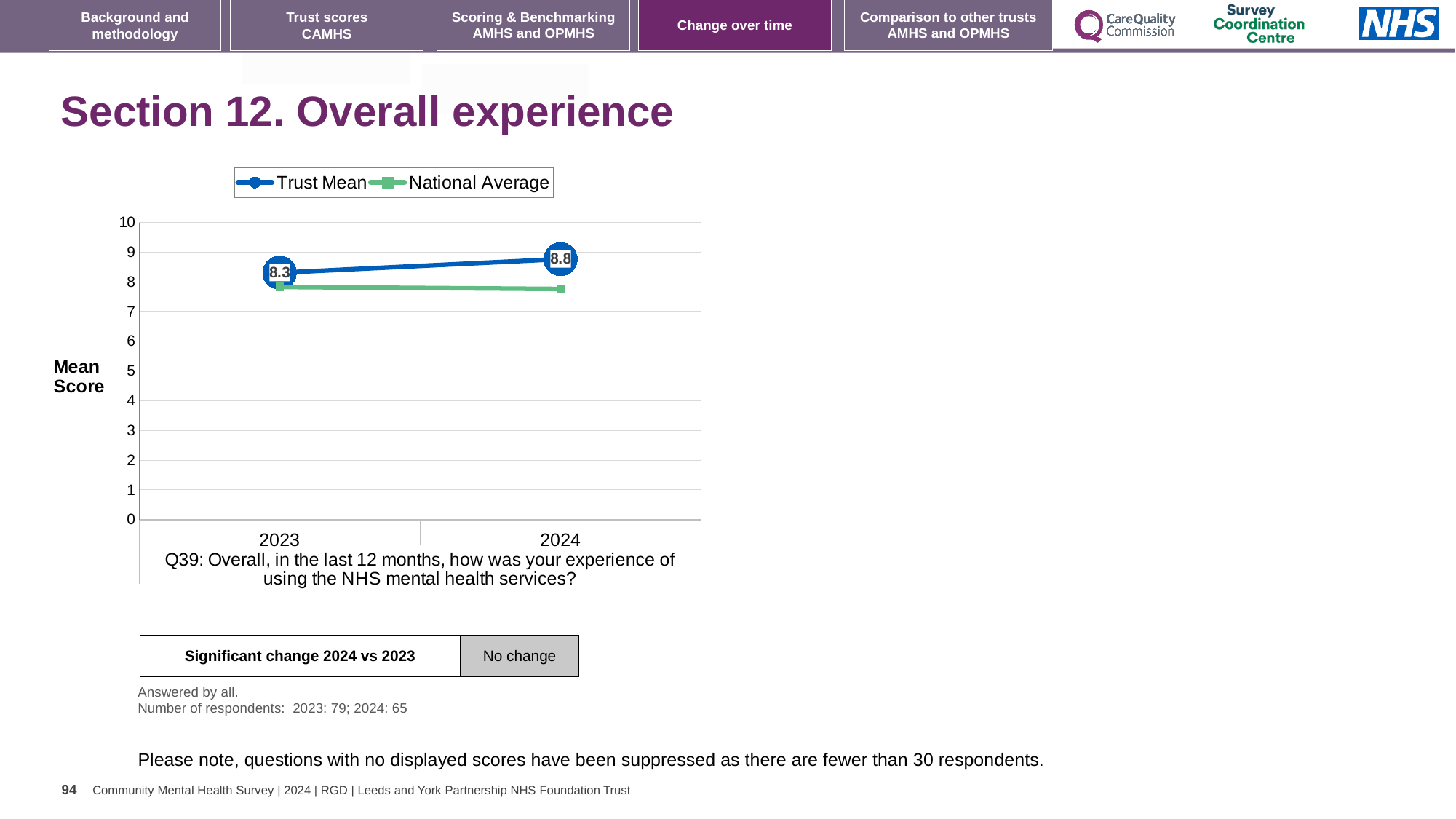
Which year has the higher Trust Mean score? 2024 Is the National Average for 2024 greater or less than 8? less How many series does the legend list? 2 What is the Trust Mean score for 2023? 8.3 By how much did the Trust Mean change from 2023 to 2024? 0.5 In 2024, which is larger: the Trust Mean or the National Average? Trust Mean Which year has the lower Trust Mean score? 2023 Is the National Average for 2023 greater or less than 7? greater Does the Trust Mean rise or fall from 2023 to 2024? rise What is the Trust Mean score for 2024? 8.8 How many years are plotted on the x axis? 2 What kind of chart is shown on the slide? line chart